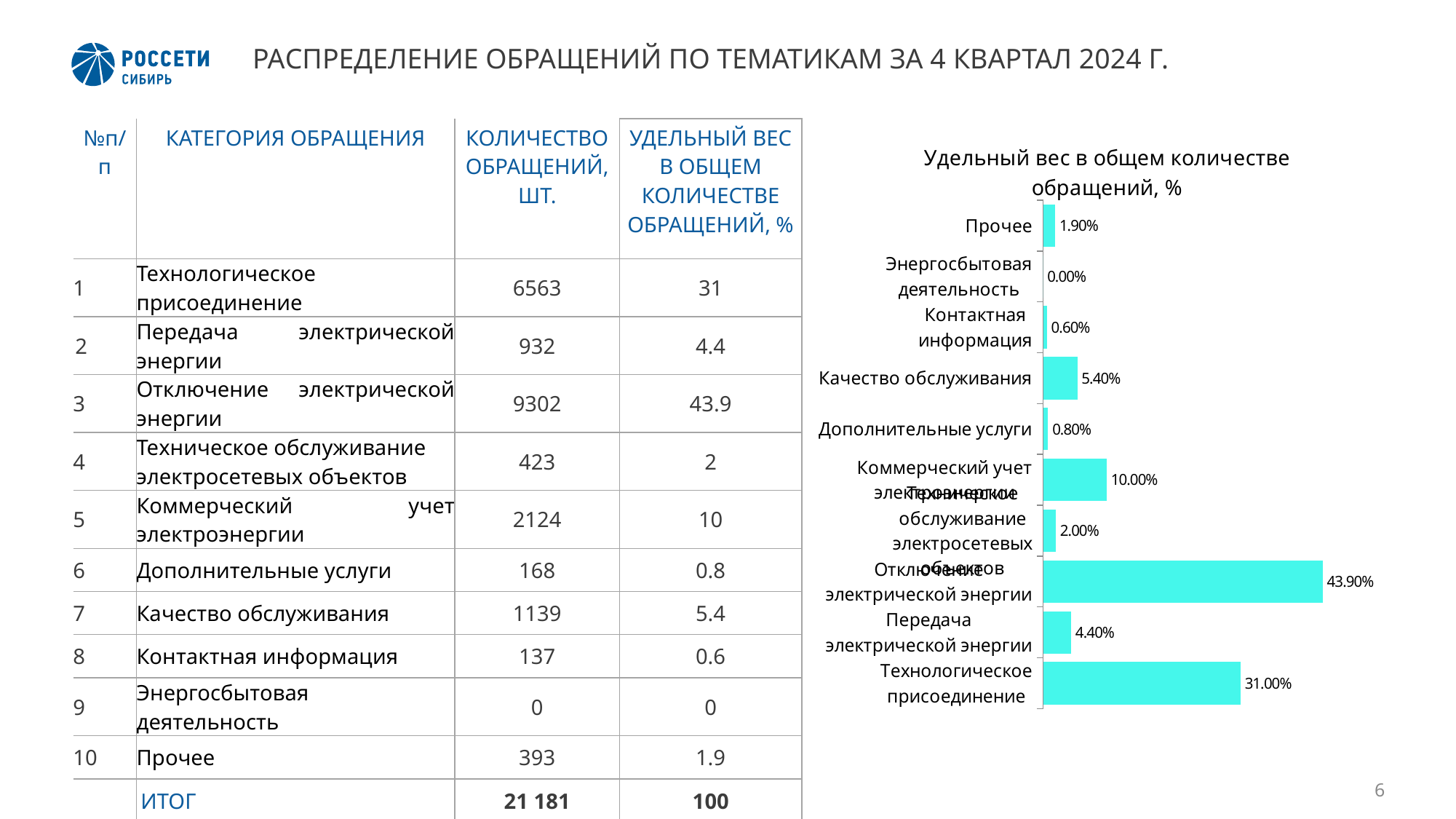
What type of chart is shown on the slide? Bar chart What value does the chart show for Отключение электрической энергии? 43.90% How many categories are plotted in the chart? 10 Which category has the lowest value in the chart? Энергосбытовая деятельность Which is larger in the chart: the value for Коммерческий учет электроэнергии or the value for Качество обслуживания? Коммерческий учет электроэнергии What value does the chart show for Технологическое присоединение? 31.00% Which category has the highest value in the chart? Отключение электрической энергии What is the difference between the values for Отключение электрической энергии and Технологическое присоединение in the chart? 12.90% What is the difference between the values for Передача электрической энергии and Дополнительные услуги in the chart? 3.60% What value does the chart show for Качество обслуживания? 5.40% What value does the chart show for Прочее? 1.90% What is the title of the chart on the slide? Удельный вес в общем количестве обращений, %